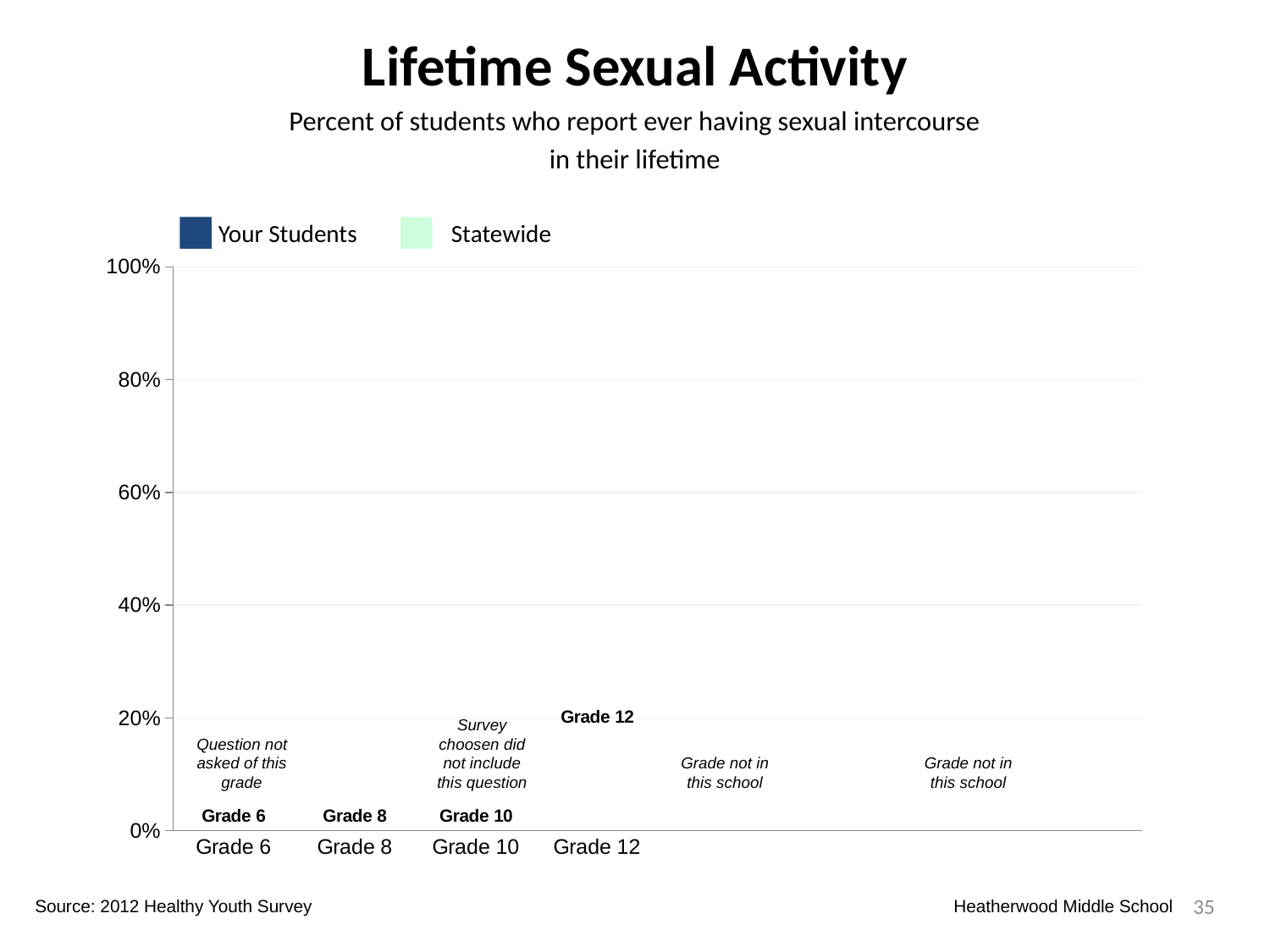
How many grade categories are labeled along the x axis? 4 What are the two series named in the legend? Your Students and Statewide What is the title of the chart? Lifetime Sexual Activity What is the highest value shown on the y axis? 100% How many series does the legend list? 2